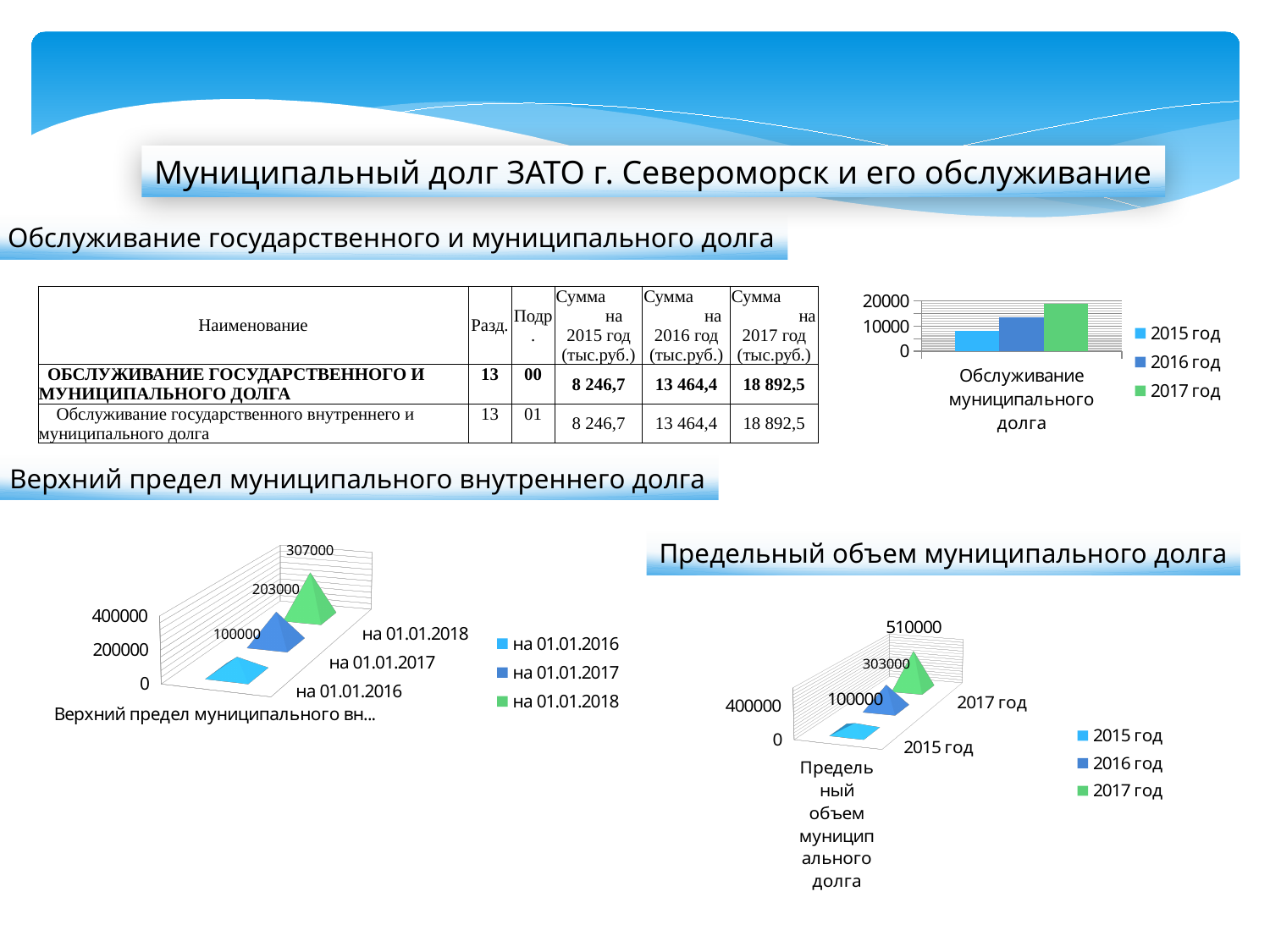
In the bottom-right chart (Предельный объем муниципального долга), do the values rise or fall from 2015 год to 2017 год? rise In the bottom-left chart (Верхний предел муниципального внутреннего долга), what is the difference between the values for на 01.01.2018 and на 01.01.2016? 207000 In the bottom-left chart (Верхний предел муниципального внутреннего долга), which date has the lowest value? на 01.01.2016 In the bottom-right chart (Предельный объем муниципального долга), what is the difference between the values for 2017 год and 2016 год? 207000 In the bottom-left chart (Верхний предел муниципального внутреннего долга), what is the value for на 01.01.2017? 203000 In the bottom-right chart (Предельный объем муниципального долга), which year has the highest value? 2017 год In the bottom-right chart (Предельный объем муниципального долга), what is the value for 2017 год? 510000 In the top-right chart (Обслуживание муниципального долга), is the value for 2015 год greater or less than 10000? less In the bottom-left chart (Верхний предел муниципального внутреннего долга), how many series does the legend list? 3 In the bottom-left chart (Верхний предел муниципального внутреннего долга), what is the value for на 01.01.2018? 307000 In the bottom-right chart (Предельный объем муниципального долга), what is the value for 2016 год? 303000 In the top-right chart (Обслуживание муниципального долга), which series is larger, 2016 год or 2017 год? 2017 год